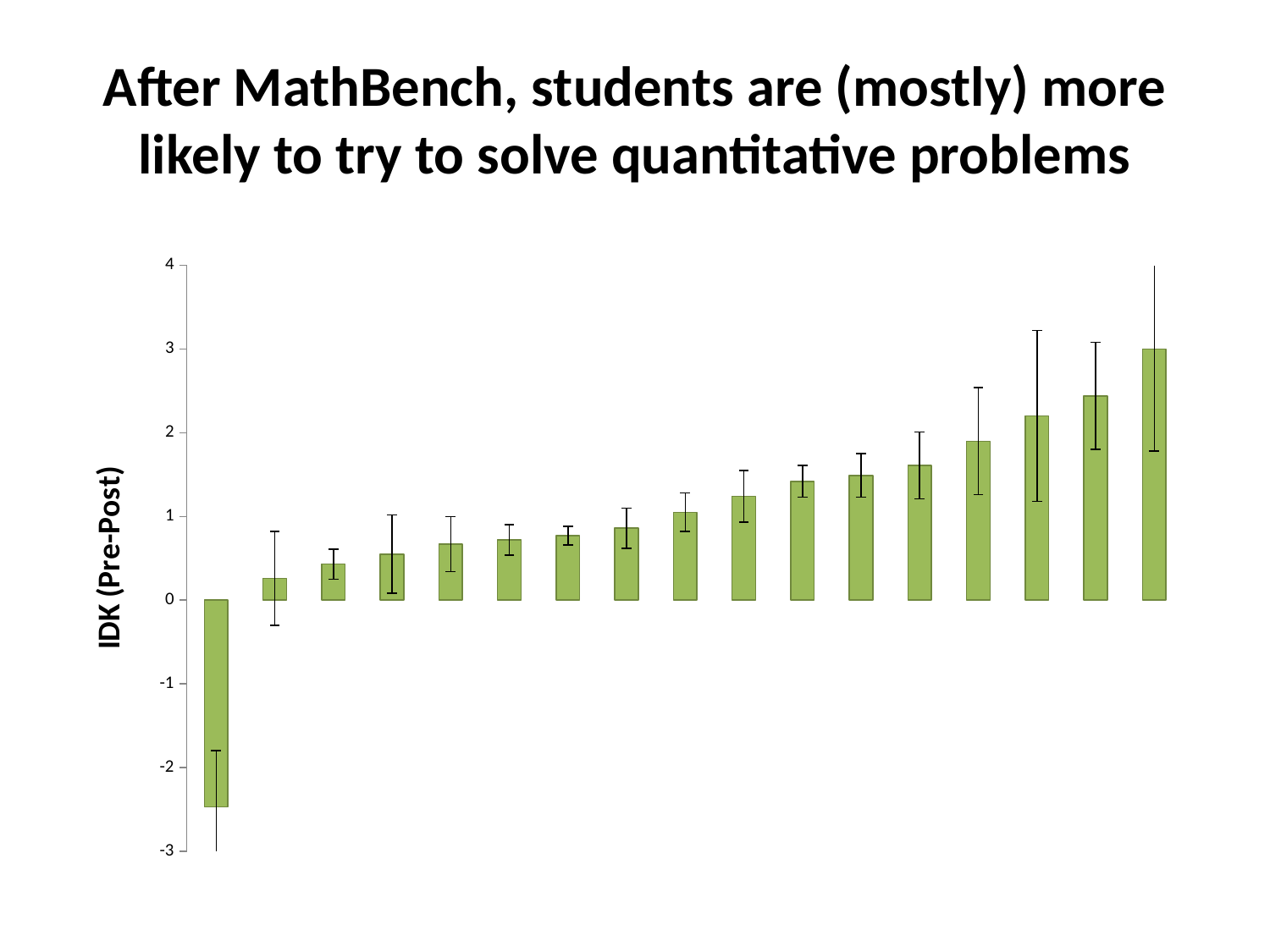
Which bar has the highest value in the chart? the rightmost bar Is the value of the second bar from the left greater or less than 1? less What is the title of the slide containing the chart? After MathBench, students are (mostly) more likely to try to solve quantitative problems What kind of chart is shown on the slide? bar chart How many bars in the chart have a negative value? 1 Is the value of the rightmost bar greater or less than 2? greater Is the value of the leftmost bar greater or less than -2? less Do the bar values generally rise or fall from left to right across the chart? rise Which bar has the lowest value in the chart? the leftmost bar How many bars are plotted in the chart? 17 Which is larger, the value of the leftmost bar or the value of the rightmost bar? the rightmost bar What is the label on the vertical axis of the chart? IDK (Pre-Post)